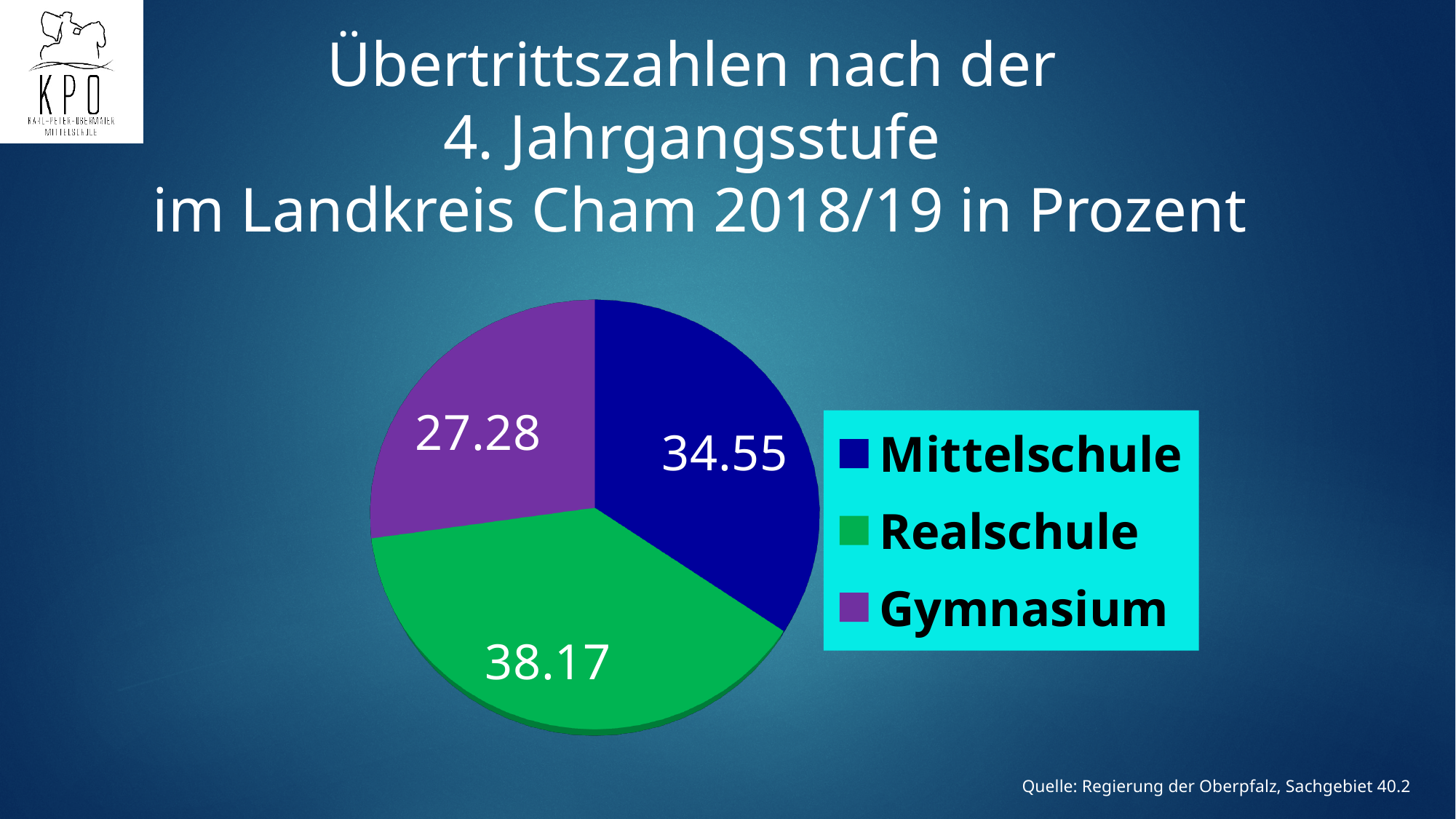
What value is shown for Realschule? 38.17 What value is shown for Mittelschule? 34.55 Which category has the smallest slice? Gymnasium What kind of chart is shown on the slide? Pie chart What is the difference between the values for Realschule and Mittelschule? 3.62 What value is shown for Gymnasium? 27.28 Which colour represents Gymnasium in the legend? Purple How many slices does the pie chart have? 3 Which category has the largest slice? Realschule Which is larger, the value for Mittelschule or the value for Gymnasium? Mittelschule What is the source cited at the bottom of the slide? Regierung der Oberpfalz, Sachgebiet 40.2 What is the difference between the values for Mittelschule and Gymnasium? 7.27